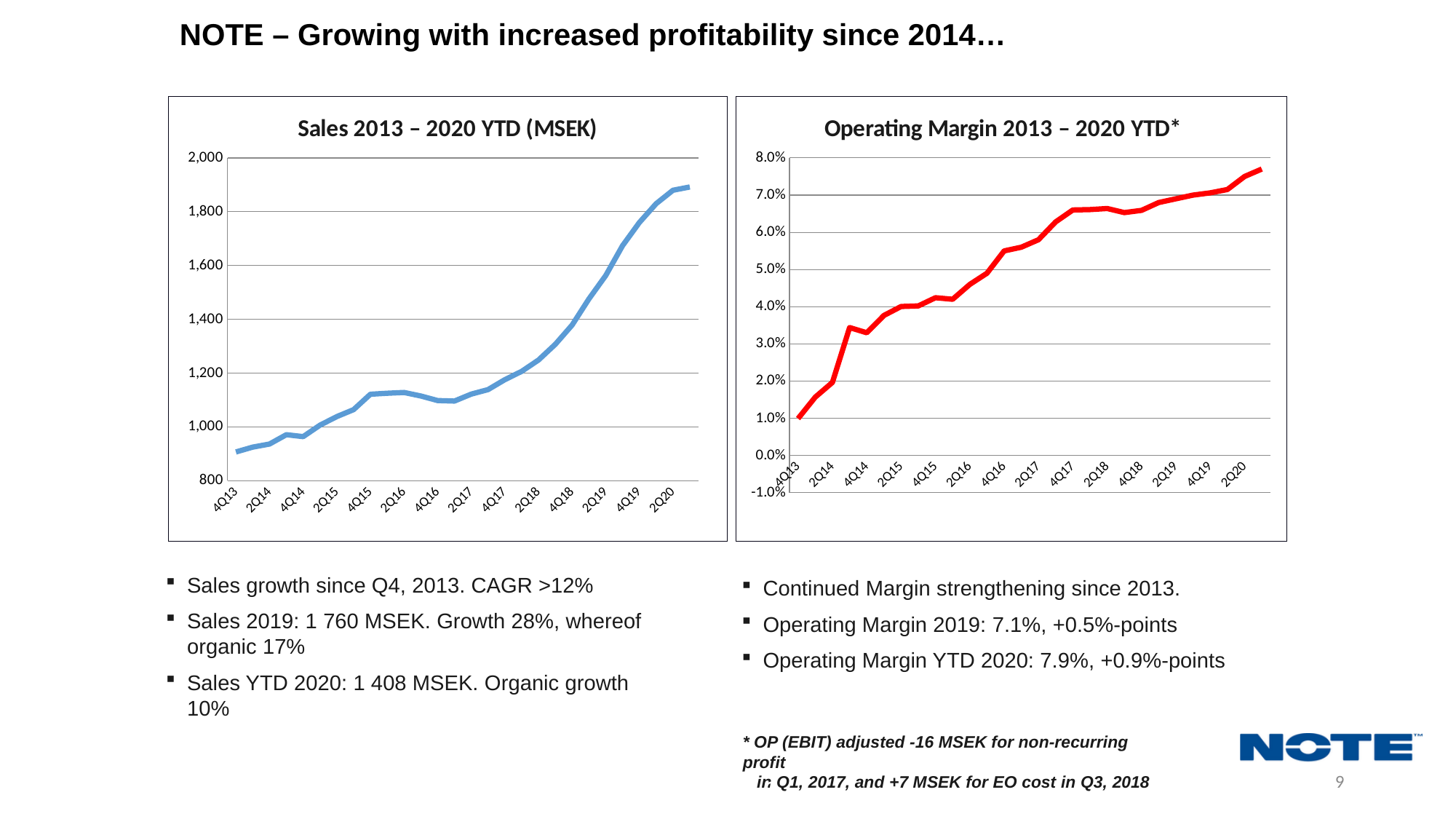
What kind of chart is the Operating Margin 2013 – 2020 YTD* chart? line chart In the Operating Margin 2013 – 2020 YTD* chart, which is larger, the value for 4Q14 or the value for 4Q16? 4Q16 In the Operating Margin 2013 – 2020 YTD* chart, is the value for 4Q13 greater or less than 2.0%? less What kind of chart is the Sales 2013 – 2020 YTD (MSEK) chart? line chart In the Sales 2013 – 2020 YTD (MSEK) chart, do sales generally rise or fall from 4Q13 to 2Q20? rise In the Sales 2013 – 2020 YTD (MSEK) chart, which is larger, the value for 4Q14 or the value for 4Q18? 4Q18 In the Operating Margin 2013 – 2020 YTD* chart, is the value for 4Q17 greater or less than 6.0%? greater In the Operating Margin 2013 – 2020 YTD* chart, does the operating margin generally rise or fall over the period shown? rise In the Sales 2013 – 2020 YTD (MSEK) chart, is the value for 4Q13 greater or less than 1,000? less What colour is the line in the Sales 2013 – 2020 YTD (MSEK) chart? blue In the Operating Margin 2013 – 2020 YTD* chart, which labelled quarter has the lowest operating margin? 4Q13